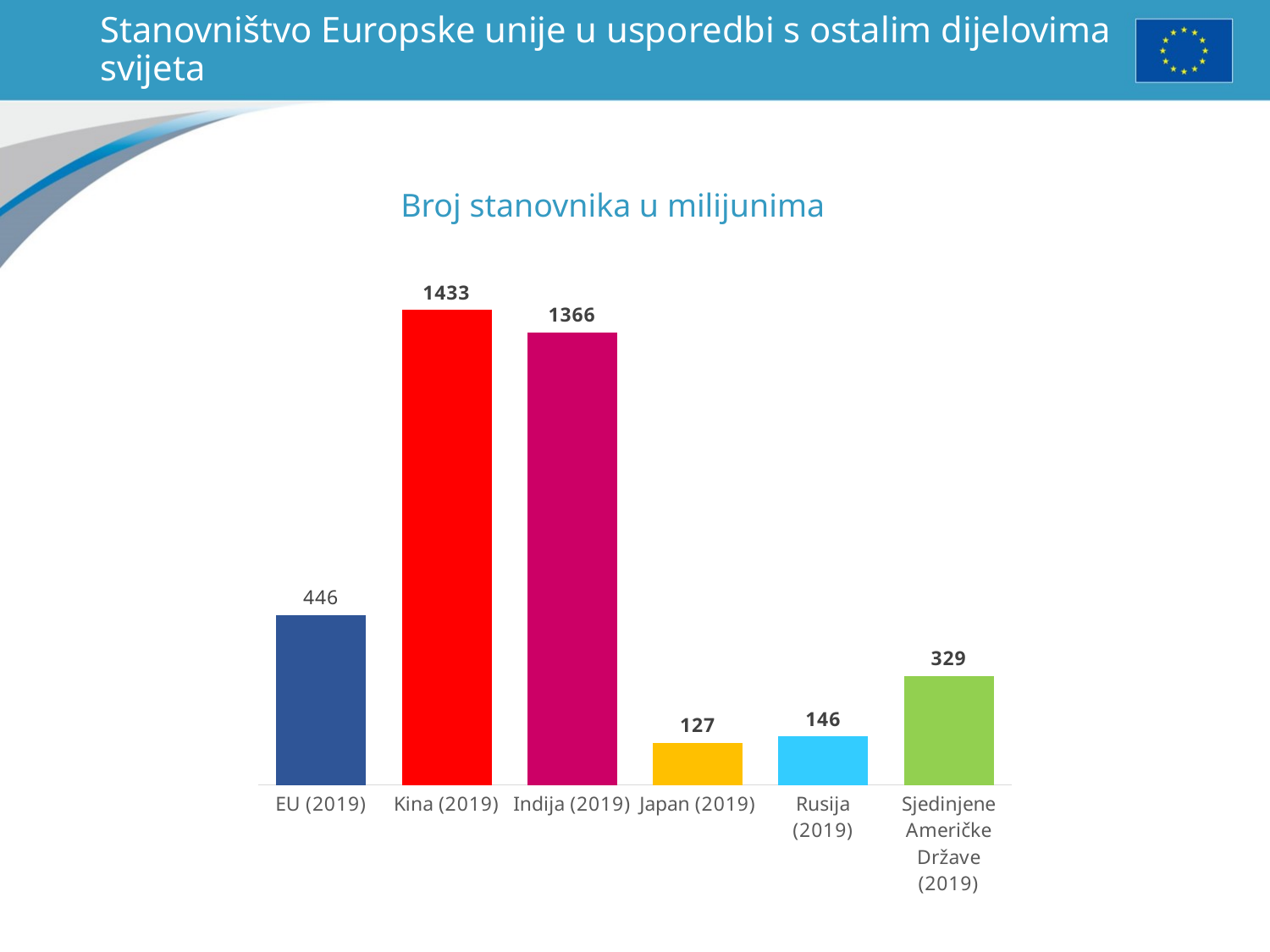
What is the title of the chart? Broj stanovnika u milijunima What is the value for Sjedinjene Američke Države (2019)? 329 Which is larger, the value for Rusija (2019) or Japan (2019)? Rusija (2019) How many categories are shown in the chart? 6 What is the value for EU (2019)? 446 What is the value for Kina (2019)? 1433 What is the difference between the values for Kina (2019) and Indija (2019)? 67 What colour is the bar for Kina (2019)? Red What kind of chart is shown on the slide? Bar chart What is the difference between the values for EU (2019) and Sjedinjene Američke Države (2019)? 117 Which category has the lowest value? Japan (2019) Which category has the highest value? Kina (2019)